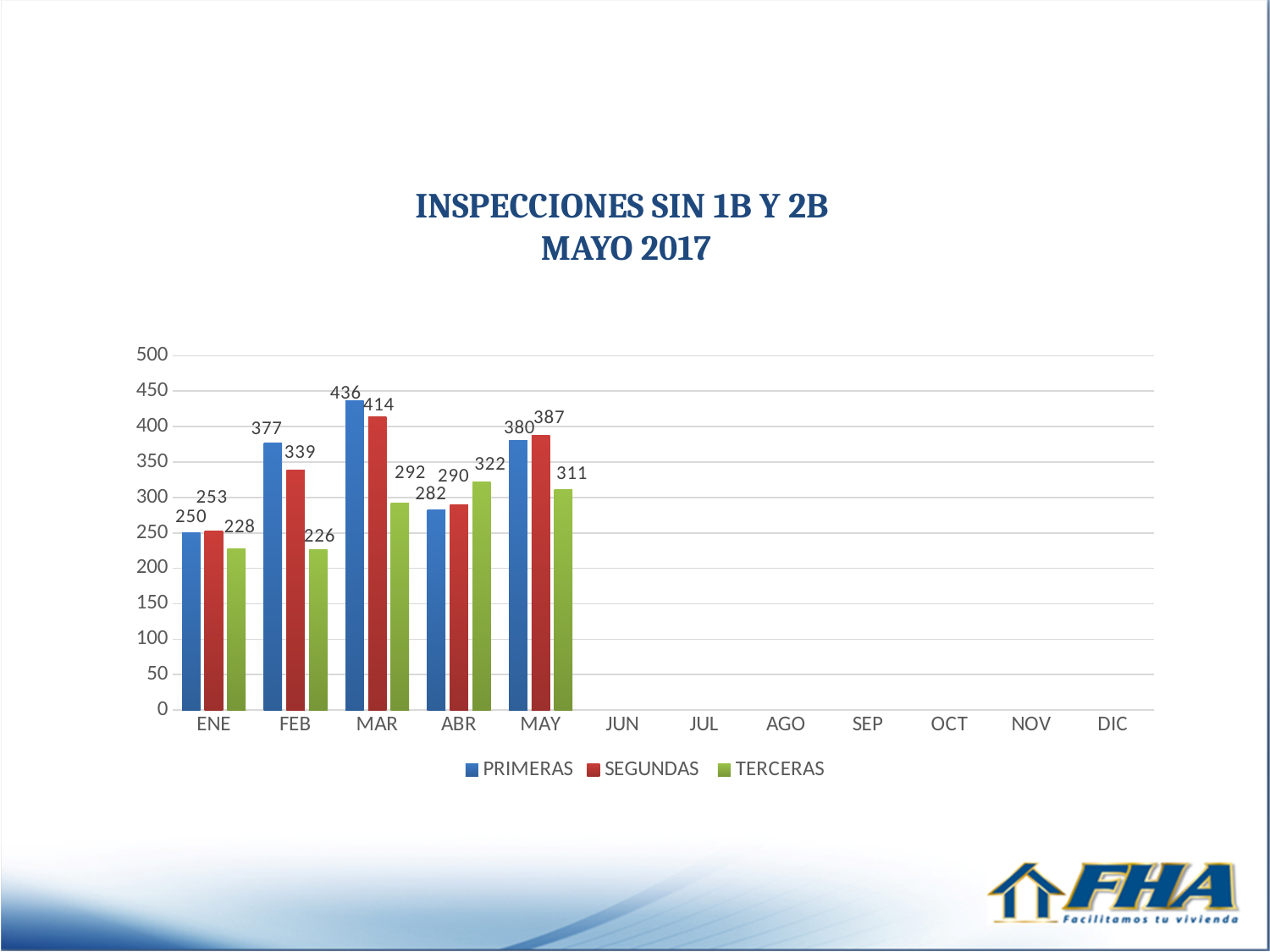
What kind of chart is shown on the slide? bar chart In which month is the TERCERAS value lowest? FEB What is the value for PRIMERAS in MAR? 436 How many series does the legend list? 3 How many months are shown on the x axis? 12 What is the value for SEGUNDAS in FEB? 339 Is the value for SEGUNDAS in MAY greater or less than 350? greater Which is larger in ABR, PRIMERAS or TERCERAS? TERCERAS What is the difference between the PRIMERAS and SEGUNDAS values in MAR? 22 What is the value for TERCERAS in ABR? 322 In which month is the PRIMERAS value highest? MAR What is the title of the chart? INSPECCIONES SIN 1B Y 2B MAYO 2017